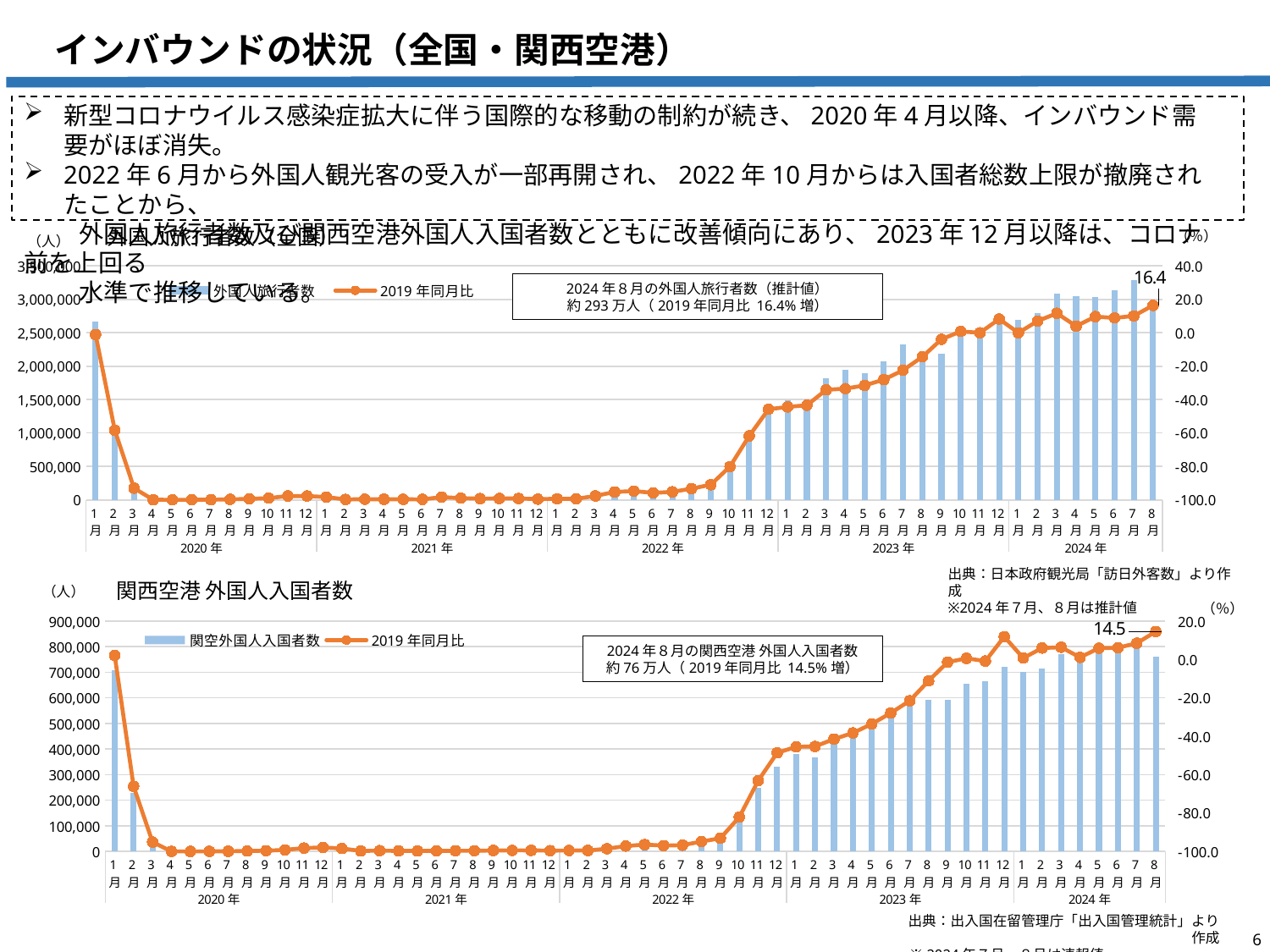
In the bottom chart (関西空港 外国人入国者数), what is the legend label for the bars? 関空外国人入国者数 In the bottom chart (関西空港 外国人入国者数), is the 2019年同月比 value for 2020年4月 greater or less than -80.0? less In the bottom chart (関西空港 外国人入国者数), is the bar value for 2024年8月 greater or less than 700,000? greater In the top chart (外国人旅行者数), is the bar value for 2024年8月 greater or less than 2,500,000? greater In the bottom chart (関西空港 外国人入国者数), which bar is larger: 2020年1月 or 2023年1月? 2020年1月 In the top chart (外国人旅行者数), how many years are labelled along the x axis? 5 In the bottom chart (関西空港 外国人入国者数), what is the value of the 2019年同月比 line for 2024年8月? 14.5 In the top chart (外国人旅行者数), what is the value of the 2019年同月比 line for 2024年8月? 16.4 What kind of chart is the top chart (外国人旅行者数)? Combined bar and line chart In the top chart (外国人旅行者数), which bar is larger: 2020年1月 or 2023年1月? 2020年1月 In the bottom chart (関西空港 外国人入国者数), do the bar values rise or fall from 2022年9月 to 2023年12月? rise In the bottom chart (関西空港 外国人入国者数), how many series does the legend list? 2